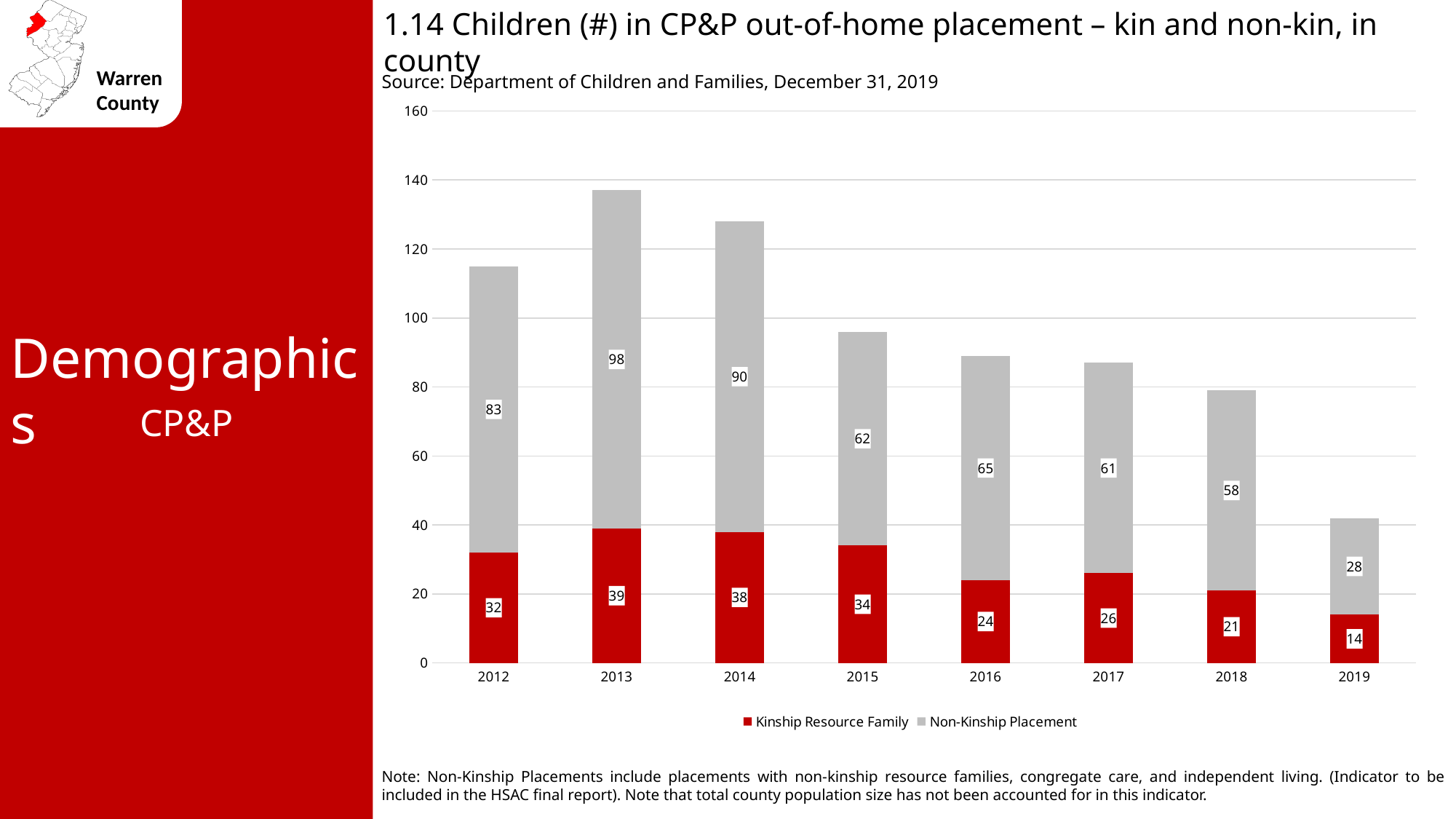
What is the Non-Kinship Placement value for 2015? 62 Which is larger, the Kinship Resource Family value for 2016 or for 2017? 2017 What is the Kinship Resource Family value for 2013? 39 Which year has the highest Non-Kinship Placement value? 2013 Is the total height of the 2012 bar greater or less than 100? greater What kind of chart is shown on the slide? Stacked bar chart What is the difference between the Non-Kinship Placement values for 2014 and 2019? 62 What is the total of the stacked bar for 2019? 42 How many years are shown on the x axis? 8 How many series does the legend list? 2 Which series is shown in red? Kinship Resource Family Which year has the lowest Kinship Resource Family value? 2019